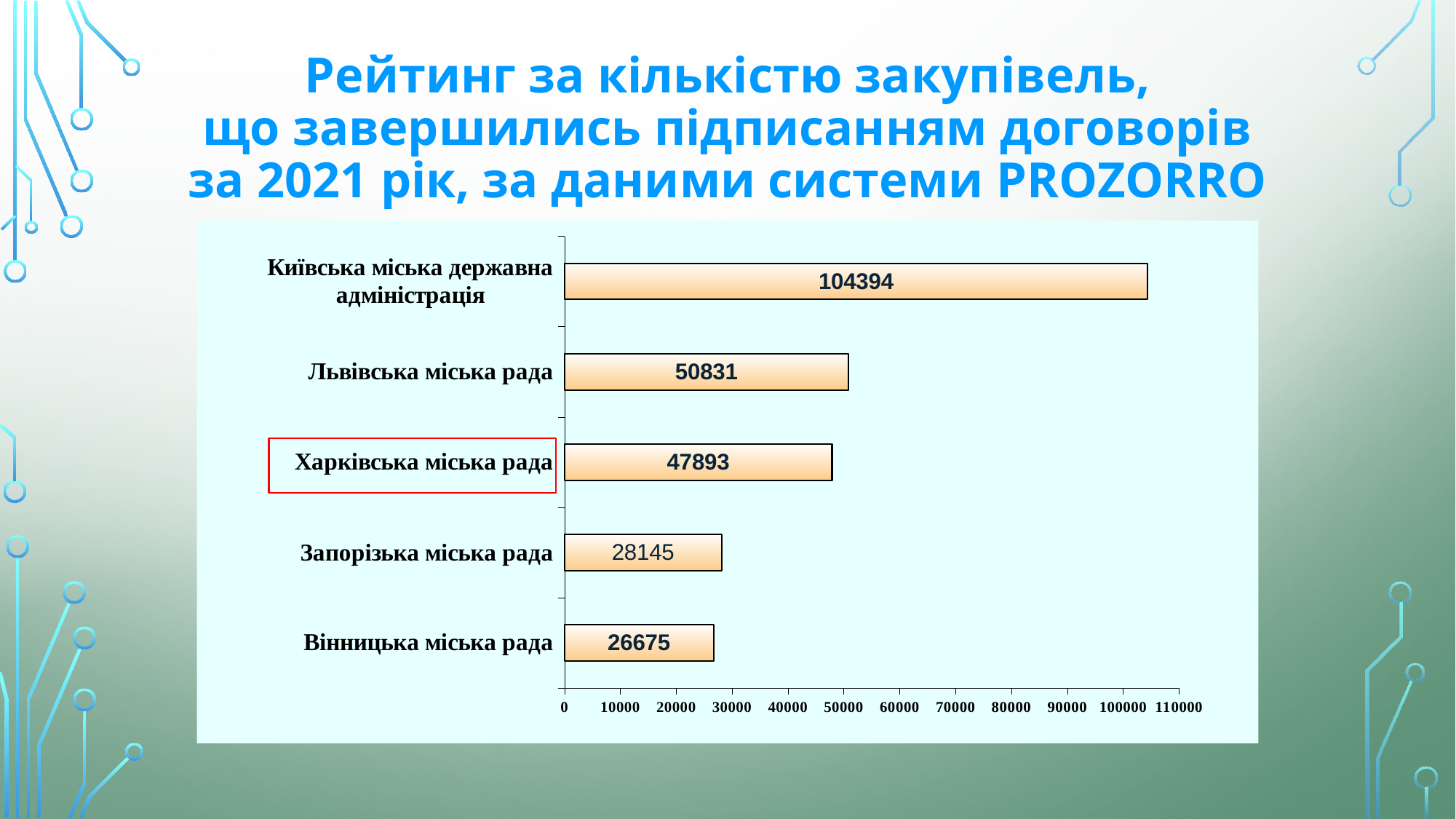
What is the value for Запорізька міська рада? 28145 What is the value for Вінницька міська рада? 26675 Is the value for Львівська міська рада greater or less than 50000? greater What is the difference between the values for Київська міська державна адміністрація and Львівська міська рада? 53563 What kind of chart is shown on the slide? bar chart Which is larger, the value for Львівська міська рада or the value for Харківська міська рада? Львівська міська рада Which category has the highest value? Київська міська державна адміністрація Which category has the lowest value? Вінницька міська рада What is the value for Харківська міська рада? 47893 What is the value for Київська міська державна адміністрація? 104394 What is the difference between the values for Львівська міська рада and Харківська міська рада? 2938 How many categories are shown in the chart? 5